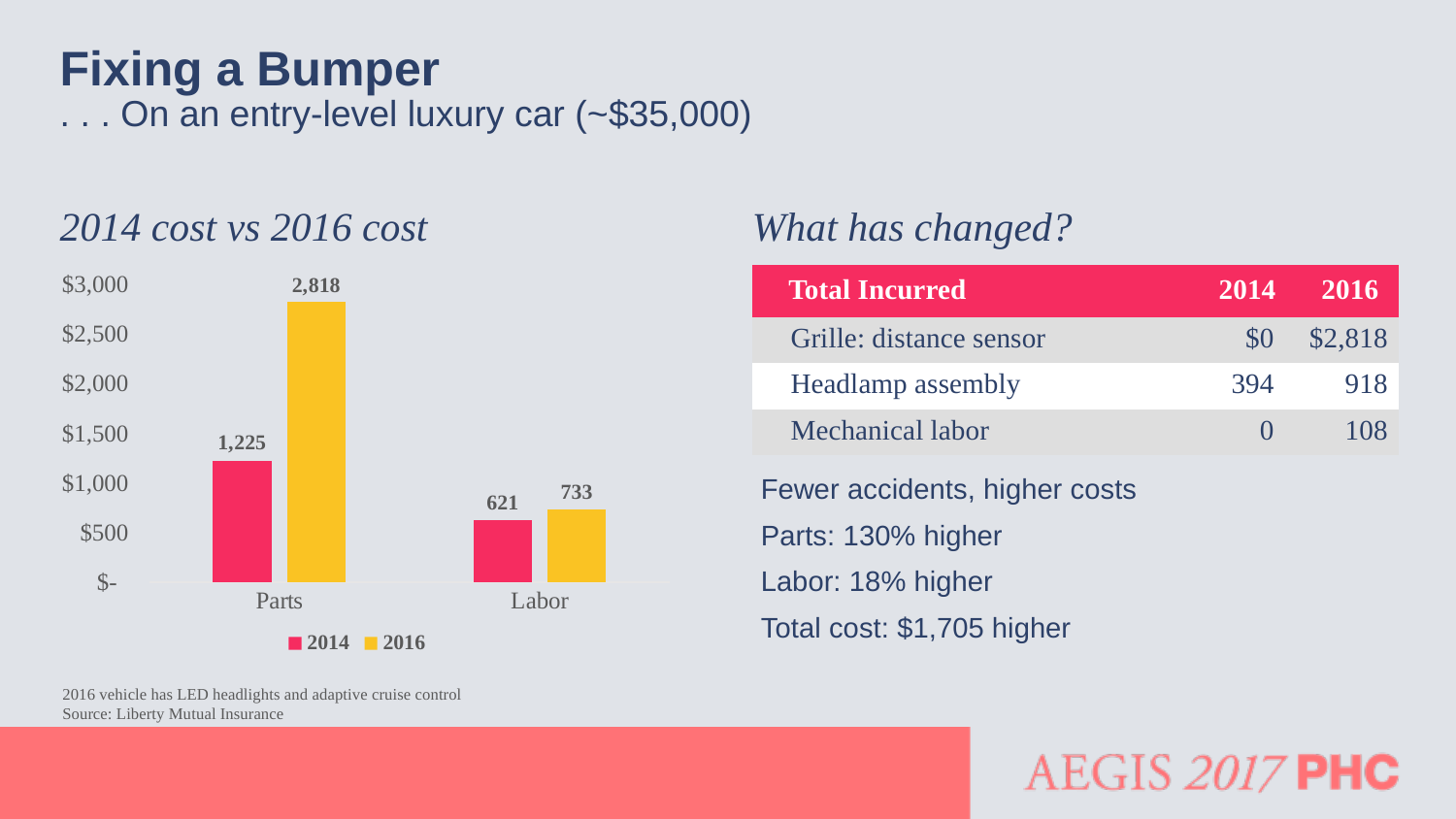
What is the difference between the 2016 and 2014 cost for Parts? 1,593 What is the 2014 cost for Labor? 621 Which is larger, the 2014 cost for Parts or the 2016 cost for Labor? 2014 cost for Parts What is the 2016 cost for Parts? 2,818 How many categories are shown on the x axis of the chart? 2 What is the 2016 cost for Labor? 733 What is the 2014 cost for Parts? 1,225 What is the difference between the 2016 and 2014 cost for Labor? 112 What kind of chart is shown on the slide? Bar chart How many series does the chart legend list? 2 Which bar in the chart has the lowest value? Labor, 2014 Which bar in the chart has the highest value? Parts, 2016